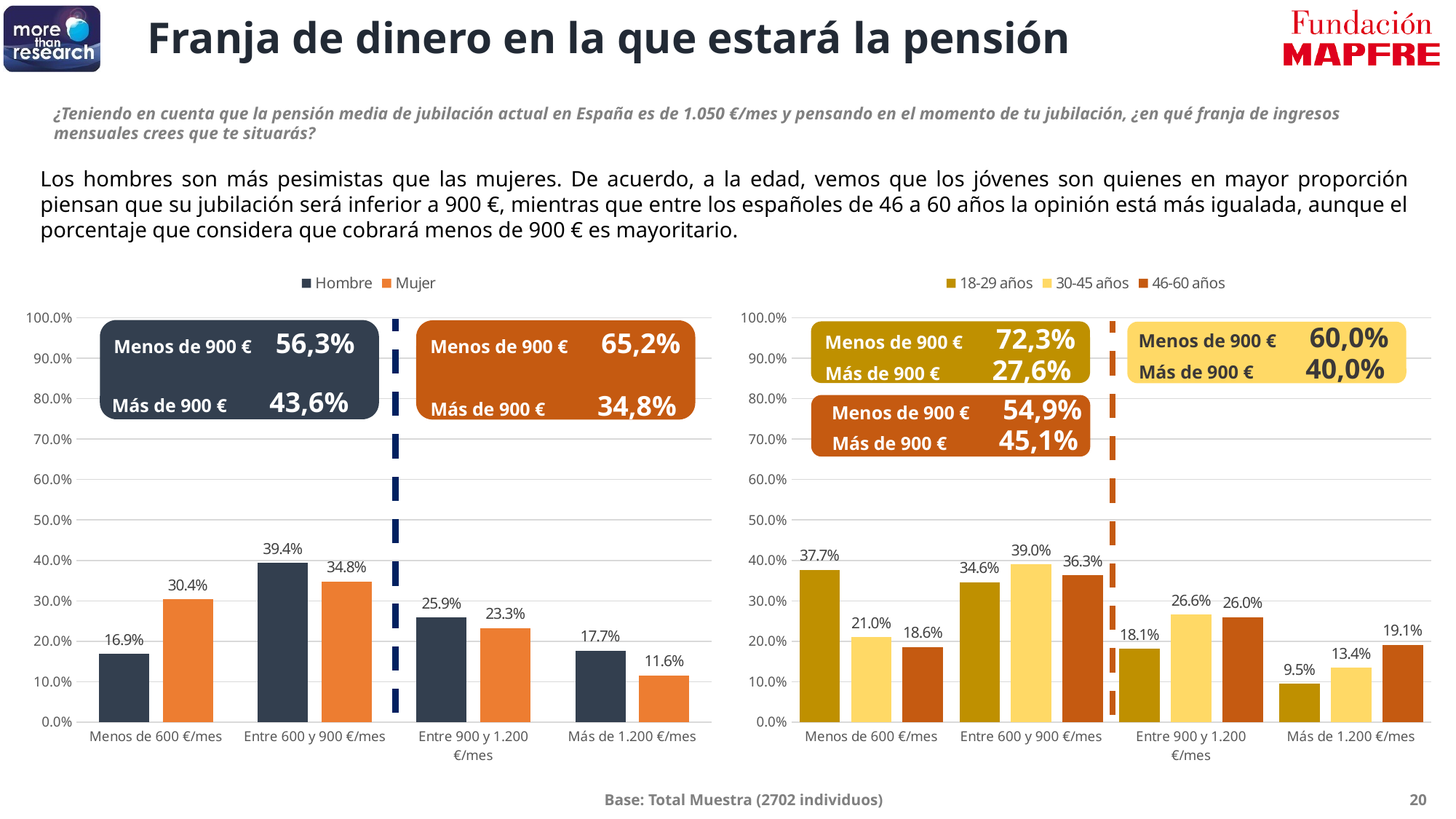
In the left chart (Hombre/Mujer), which category has the highest value for Hombre? Entre 600 y 900 €/mes In the right chart (age groups), what is the value for 30-45 años in the 'Entre 600 y 900 €/mes' category? 39.0% In the right chart (age groups), how many categories are shown on the x axis? 4 In the right chart (age groups), what kind of chart is it? Bar chart In the left chart (Hombre/Mujer), what is the value for Hombre in the 'Menos de 600 €/mes' category? 16.9% In the left chart (Hombre/Mujer), what is the value for Mujer in the 'Más de 1.200 €/mes' category? 11.6% In the right chart (age groups), which age group has the lowest value in the 'Más de 1.200 €/mes' category? 18-29 años In the right chart (age groups), what percentage of 18-29 años expect a pension of 'Menos de 900 €' according to the summary box? 72,3% In the right chart (age groups), what is the difference between 18-29 años and 46-60 años in the 'Menos de 600 €/mes' category? 19.1% In the left chart (Hombre/Mujer), what is the difference between Mujer and Hombre in the 'Menos de 600 €/mes' category? 13.5% In the left chart (Hombre/Mujer), how many series does the legend list? 2 In the left chart (Hombre/Mujer), which is larger in the 'Entre 900 y 1.200 €/mes' category, Hombre or Mujer? Hombre